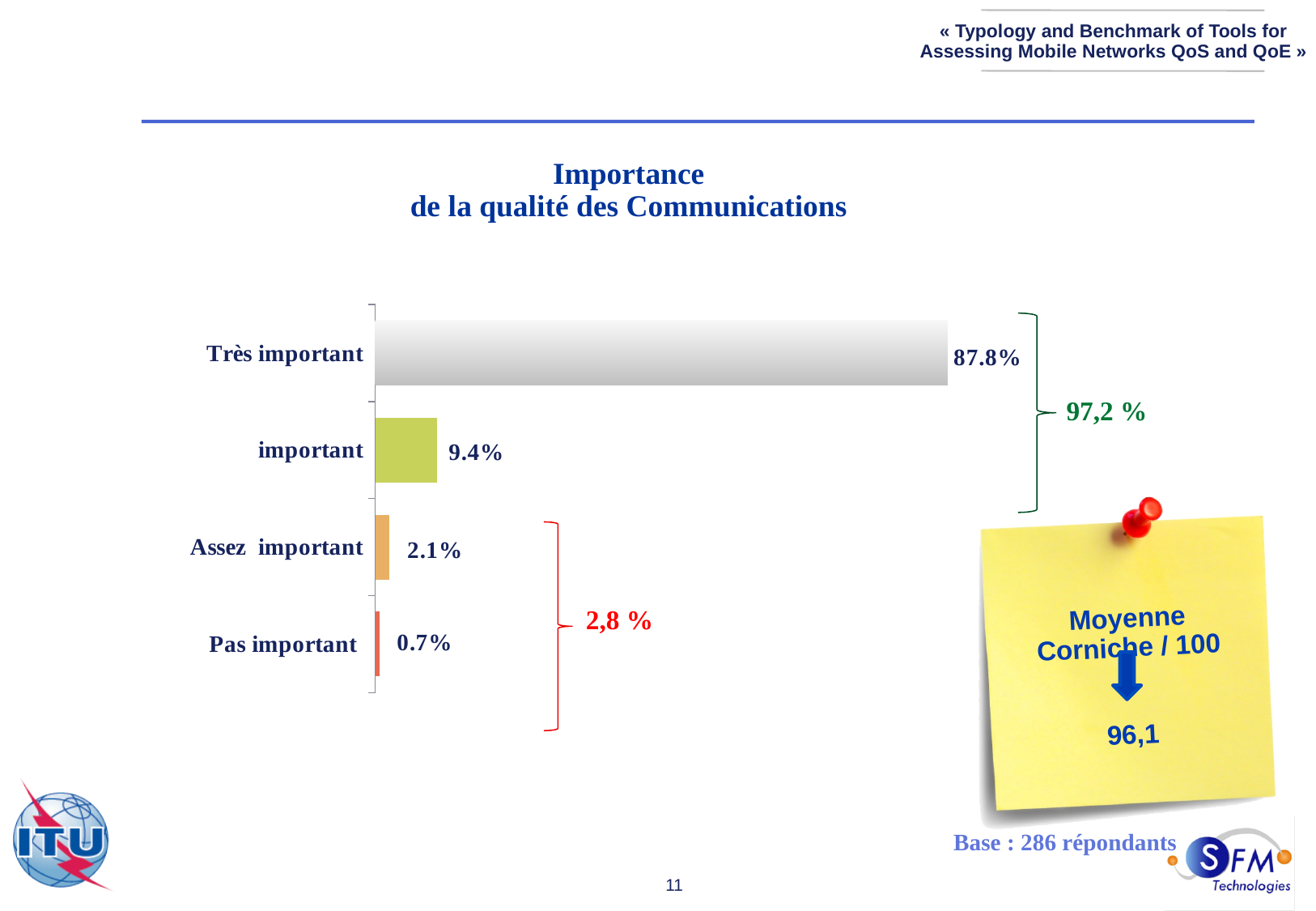
What kind of chart is shown on the slide? Bar chart What is the difference between the values for "Très important" and "important"? 78.4% What is the value for "important"? 9.4% Which category has the highest value? Très important What combined percentage is shown by the bracket grouping "Très important" and "important"? 97,2 % What is the title of the chart? Importance de la qualité des Communications Which category has the lowest value? Pas important What is the value for "Très important"? 87.8% What is the value for "Assez important"? 2.1% Which is larger, the value for "Assez important" or the value for "Pas important"? Assez important How many categories are shown in the chart? 4 What is the value for "Pas important"? 0.7%